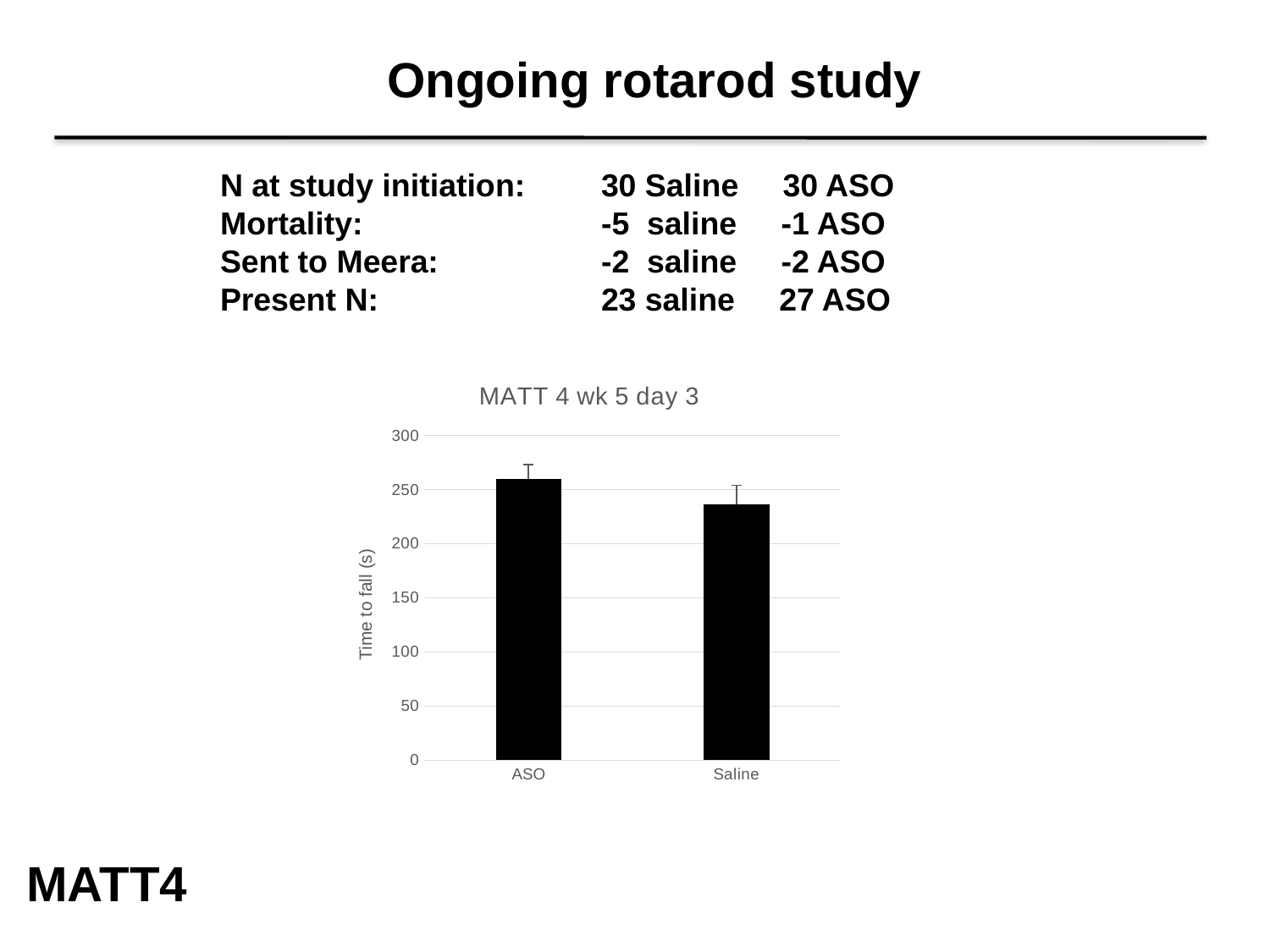
Is the value for ASO greater or less than 300? less Is the value for Saline greater or less than 250? less Which has a larger time to fall, ASO or Saline? ASO Which category has the lowest time to fall? Saline Which category has the highest time to fall? ASO What kind of chart is shown on the slide? bar chart What is the label of the y axis? Time to fall (s) Is the value for ASO greater or less than 200? greater How many categories are plotted in the chart? 2 Do the values rise or fall going from ASO to Saline along the x axis? fall What is the title of the chart? MATT 4 wk 5 day 3